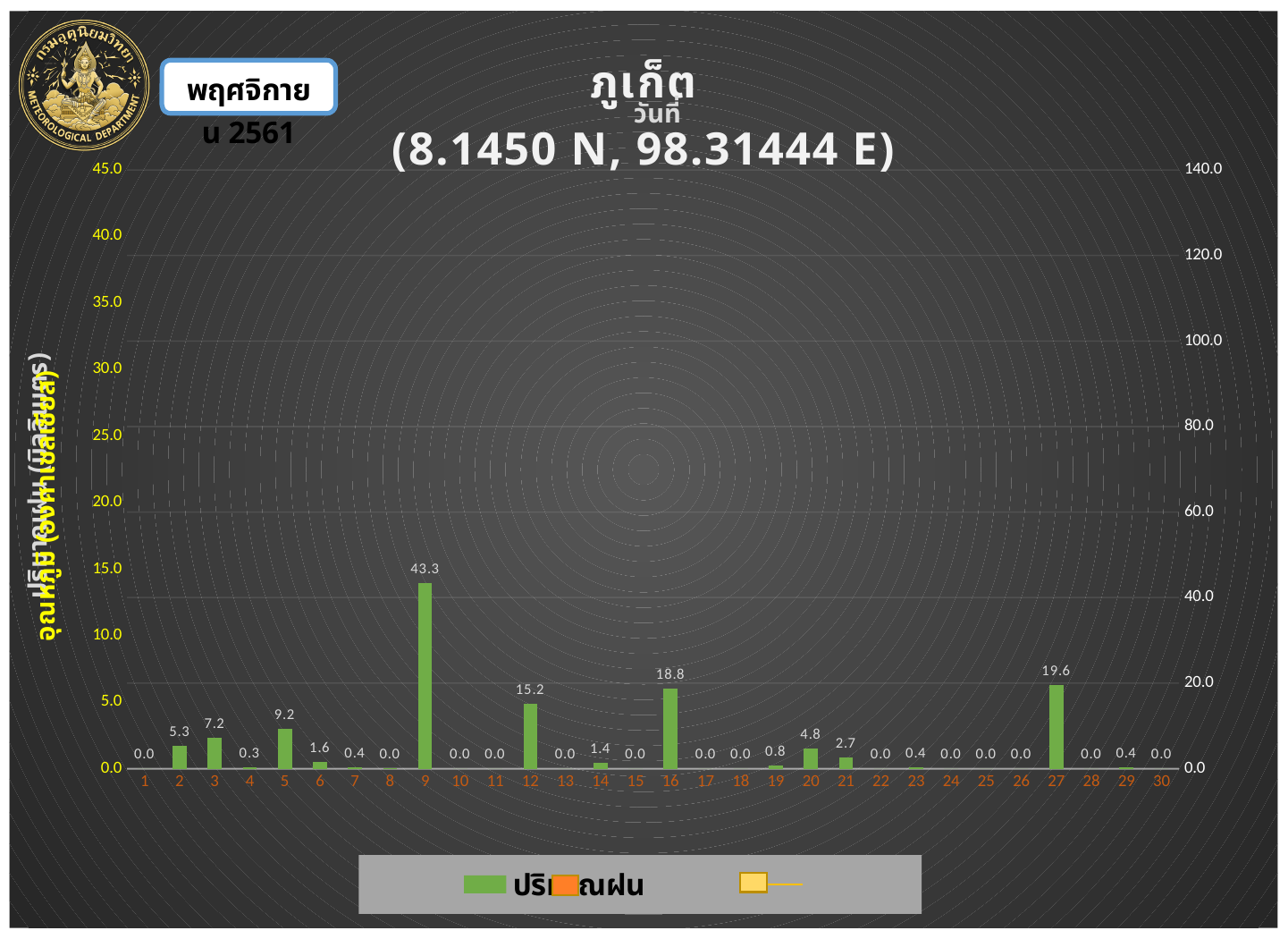
Which day has the highest rainfall value? 9 What coordinates are given in the chart title? 8.1450 N, 98.31444 E What is the difference between the rainfall values for day 16 and day 12? 3.6 What is the rainfall value shown for day 16? 18.8 What is the rainfall value shown for day 5? 9.2 What is the rainfall value shown for day 27? 19.6 What is the difference between the rainfall values for day 9 and day 27? 23.7 What is the rainfall value shown for day 9? 43.3 What kind of chart is shown on the slide? bar chart Which is larger, the rainfall value for day 3 or for day 20? day 3 How many days are shown on the x axis? 30 Which is larger, the rainfall value for day 12 or for day 16? day 16